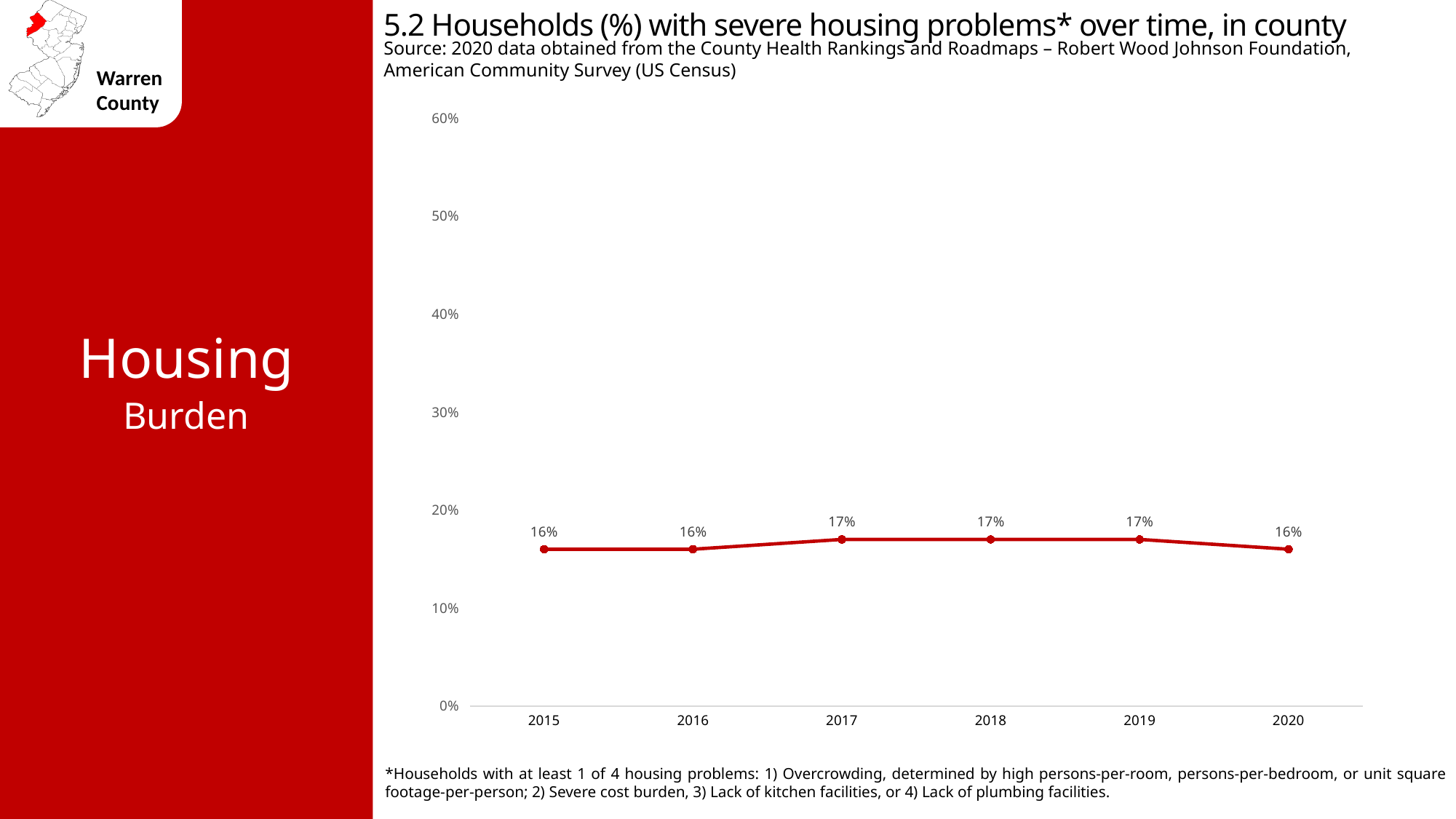
Did the value rise or fall from 2019 to 2020? fall What percentage of households had severe housing problems in 2020? 16% What percentage of households had severe housing problems in 2015? 16% What percentage of households had severe housing problems in 2017? 17% Is the value for 2016 greater or less than 10%? greater What kind of chart is shown on the slide? line chart Is the value for 2019 greater or less than 20%? less What is the title of the chart? 5.2 Households (%) with severe housing problems* over time, in county Which years show the highest value on the chart? 2017, 2018 and 2019 How many years are plotted on the chart? 6 What is the difference between the 2018 value and the 2016 value? 1% What is the highest value shown on the vertical axis? 60%